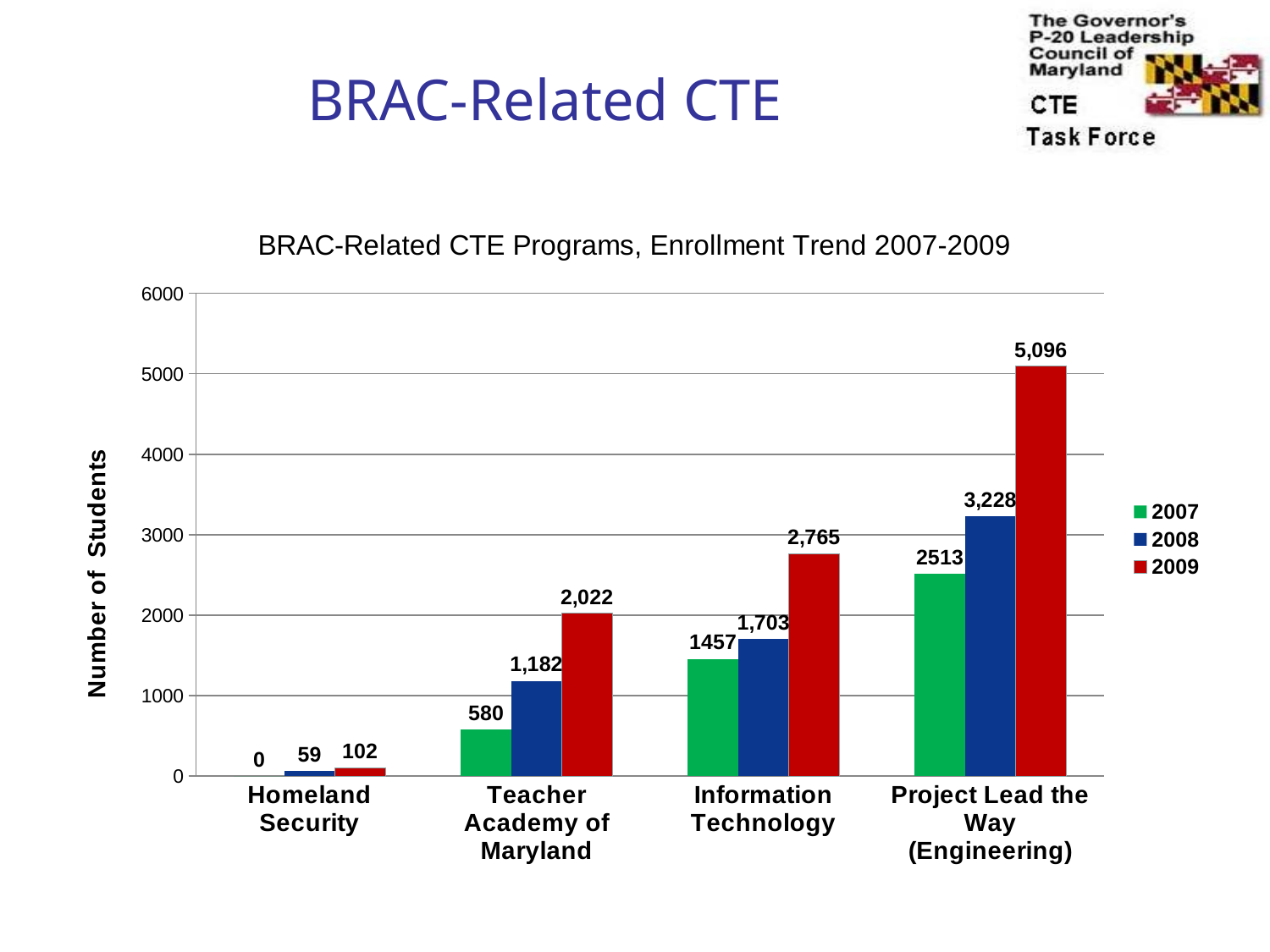
What was the 2007 enrollment for Homeland Security? 0 Which program had the highest enrollment in 2009? Project Lead the Way (Engineering) What was the 2009 enrollment for Project Lead the Way (Engineering)? 5,096 Which is larger: the 2009 enrollment for Information Technology or the 2007 enrollment for Project Lead the Way (Engineering)? 2009 enrollment for Information Technology How many series does the legend list? 3 What is the title of the chart? BRAC-Related CTE Programs, Enrollment Trend 2007-2009 What was the 2007 enrollment for Teacher Academy of Maryland? 580 What kind of chart is this? Bar chart How many programs are shown on the x axis? 4 What was the 2008 enrollment for Information Technology? 1,703 What is the difference between the 2009 and 2008 enrollment for Project Lead the Way (Engineering)? 1,868 Which program had the lowest enrollment in 2008? Homeland Security